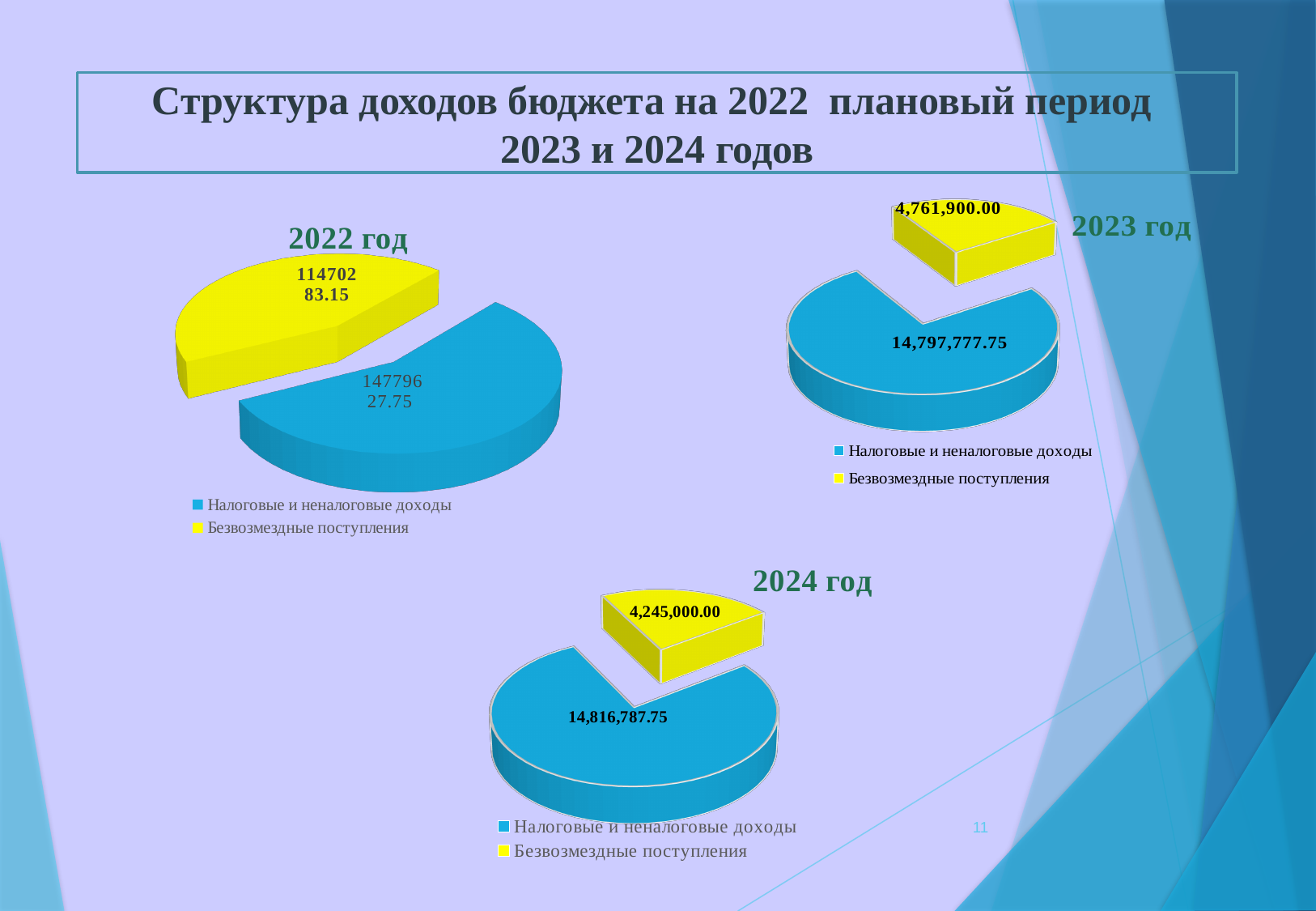
In the 2024 год chart, which category has the largest slice? Налоговые и неналоговые доходы In the 2024 год chart, what is the value for Безвозмездные поступления? 4,245,000.00 In the 2024 год chart, what is the value for Налоговые и неналоговые доходы? 14,816,787.75 Which is larger: Безвозмездные поступления in the 2023 год chart or in the 2024 год chart? 2023 год How many legend entries does the 2022 год chart list? 2 How many pie charts are on the slide? 3 In the 2023 год chart, what is the value for Безвозмездные поступления? 4,761,900.00 In the 2023 год chart, what is the difference between Налоговые и неналоговые доходы and Безвозмездные поступления? 10,035,877.75 What kind of charts are shown on the slide? Pie charts In the 2023 год chart, which category has the smallest slice? Безвозмездные поступления In the 2023 год chart, what is the value for Налоговые и неналоговые доходы? 14,797,777.75 In the 2024 год chart, what is the total of the two slices? 19,061,787.75